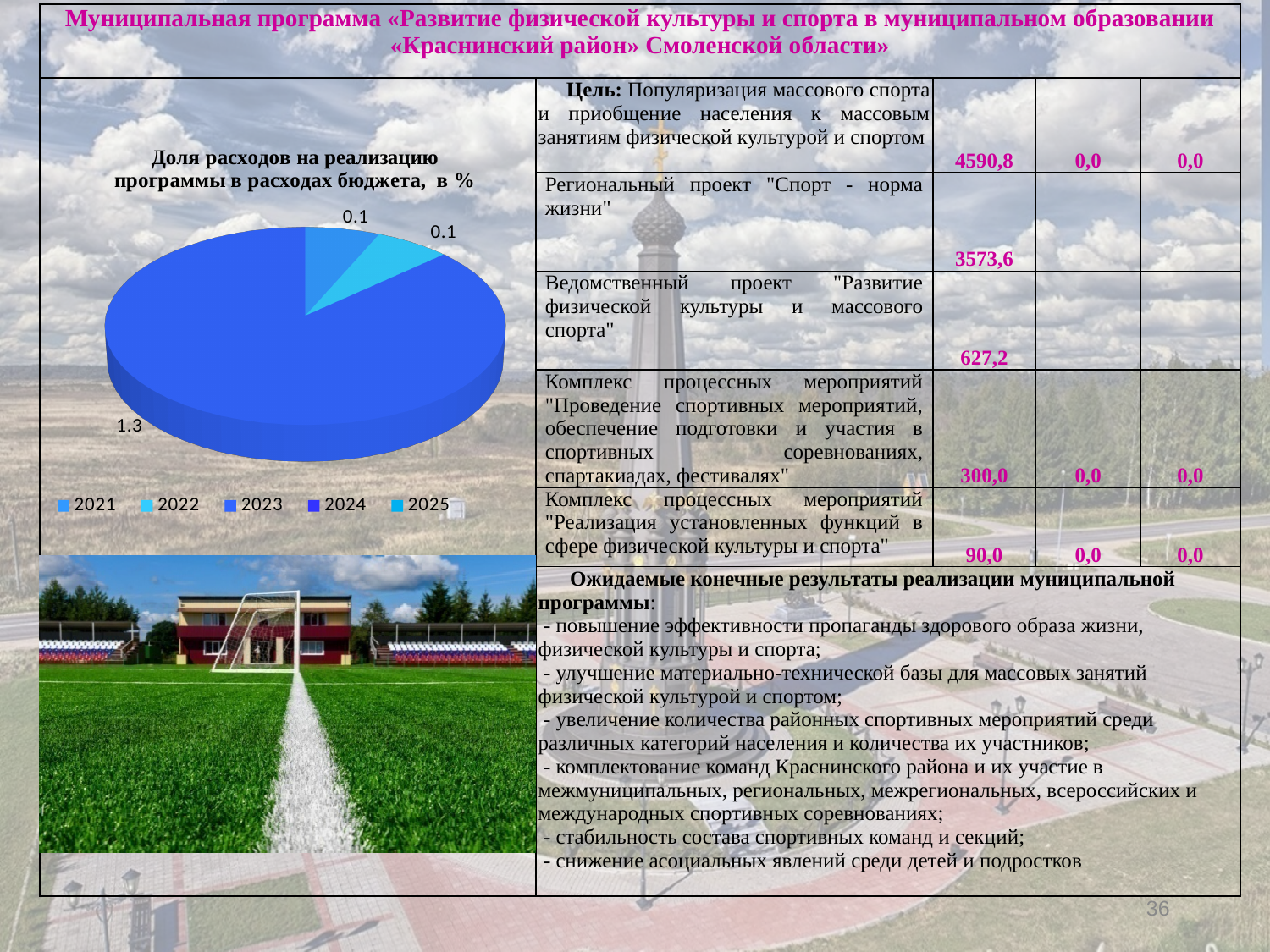
What is the value of the largest slice in the pie chart? 1.3 Which is larger in the pie chart: the slice labelled 1.3 or a slice labelled 0.1? 1.3 What is the title of the pie chart? Доля расходов на реализацию программы в расходах бюджета, в % Is the value of the largest slice in the pie chart greater or less than 1? greater What kind of chart is shown on the slide? pie chart What is the difference between the largest slice (1.3) and one of the small slices (0.1) in the pie chart? 1.2 What is the sum of all the labelled slice values in the pie chart? 1.5 How many slices in the pie chart have a data label? 3 What is the value of the smallest labelled slice in the pie chart? 0.1 How many entries does the legend of the pie chart list? 5 Which years are listed in the legend of the pie chart? 2021, 2022, 2023, 2024, 2025